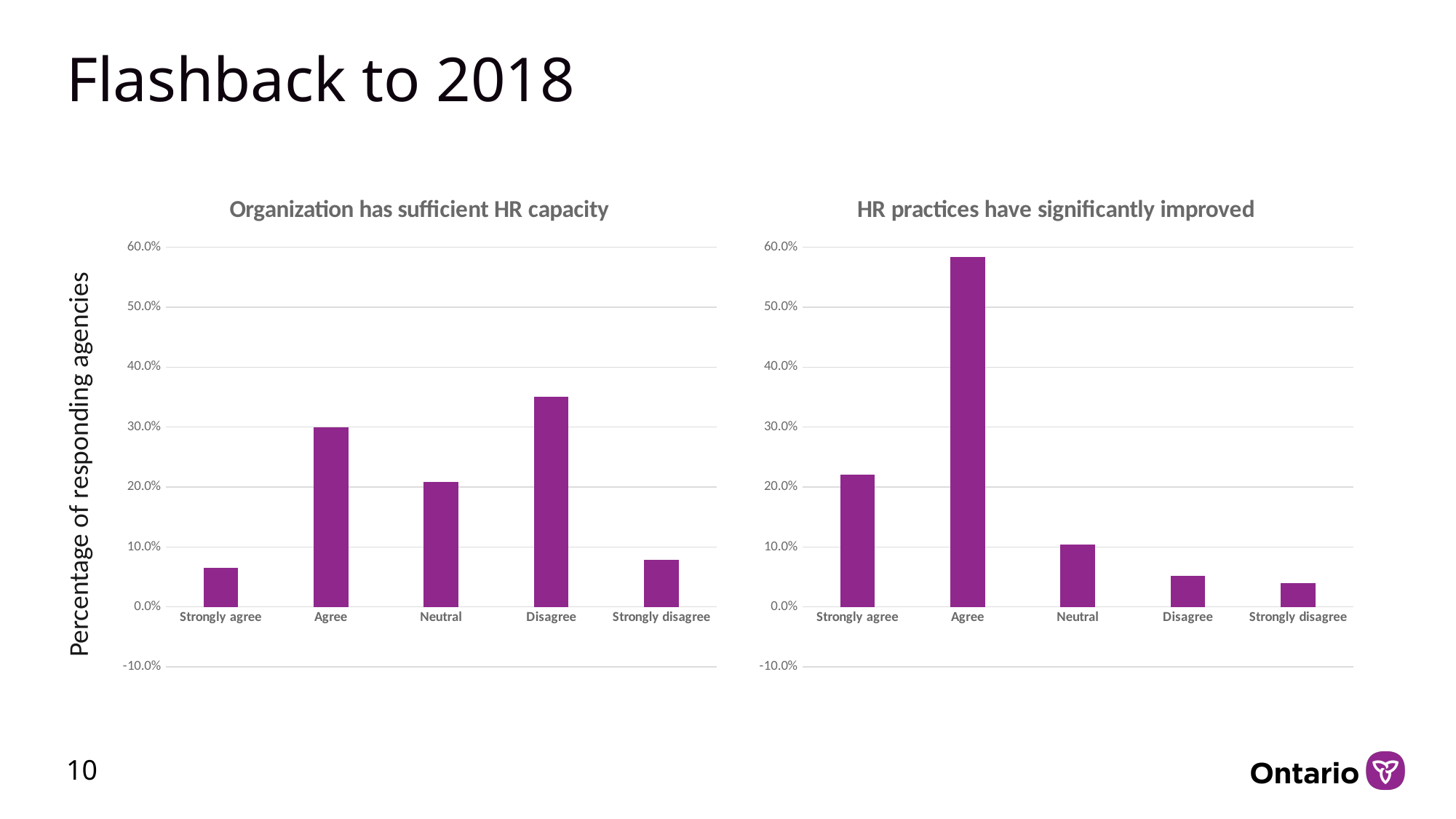
In the 'HR practices have significantly improved' chart, which is larger, the value for Strongly agree or the value for Disagree? Strongly agree In the 'Organization has sufficient HR capacity' chart, which category has the highest value? Disagree In the 'Organization has sufficient HR capacity' chart, which is larger, the value for Agree or the value for Neutral? Agree In the 'Organization has sufficient HR capacity' chart, is the value for Disagree greater or less than 30.0%? greater What is the y-axis label shown on the left of the slide? Percentage of responding agencies In the 'HR practices have significantly improved' chart, is the value for Agree greater or less than 50.0%? greater In the 'HR practices have significantly improved' chart, which category has the highest value? Agree In the 'Organization has sufficient HR capacity' chart, which category has the lowest value? Strongly agree In the 'HR practices have significantly improved' chart, which category has the lowest value? Strongly disagree What kind of chart is the 'HR practices have significantly improved' chart? Bar chart In the 'HR practices have significantly improved' chart, is the value for Neutral greater or less than 20.0%? less How many categories are shown on the x axis of the 'Organization has sufficient HR capacity' chart? 5